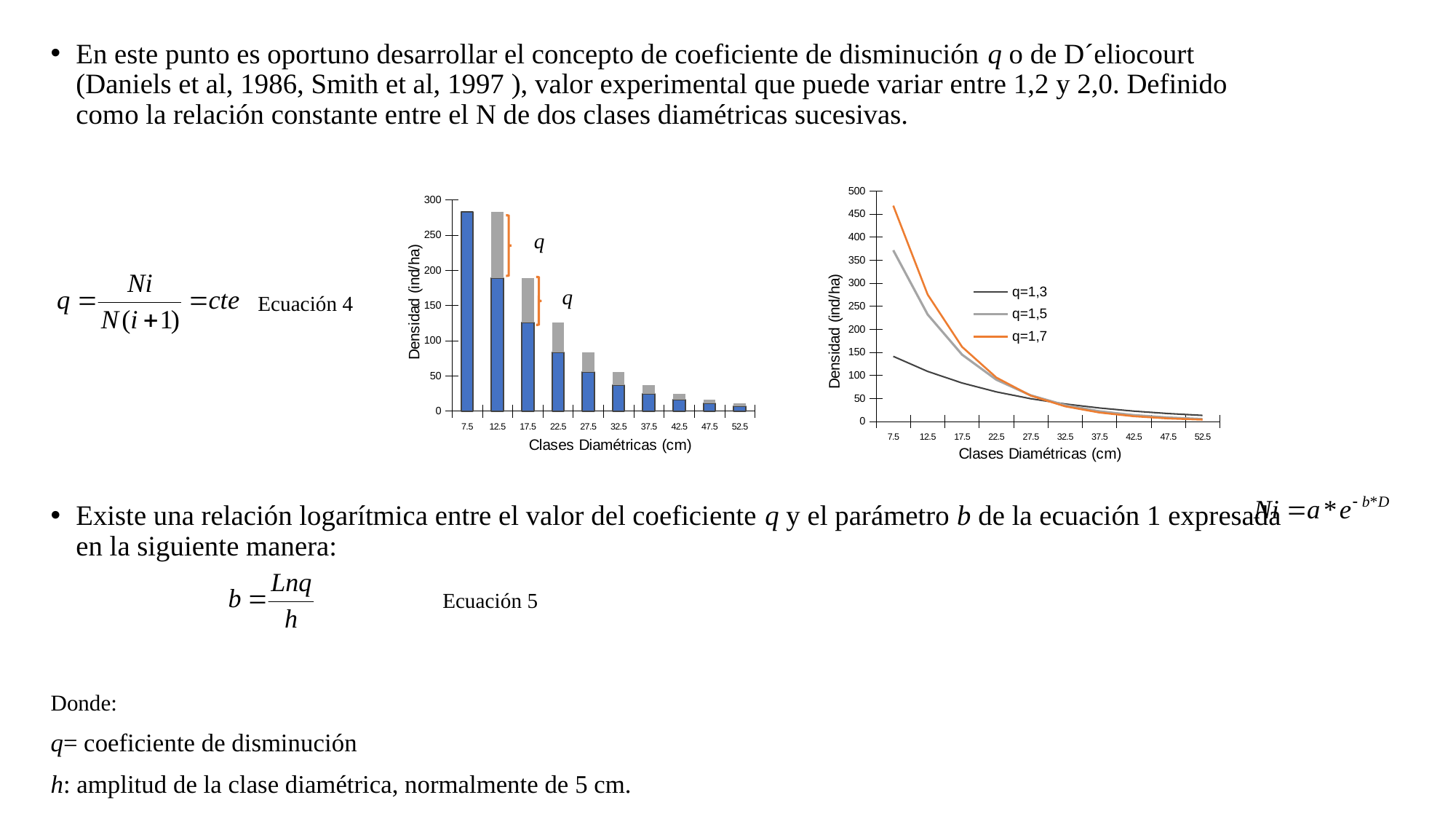
What kind of chart is the chart on the right of the slide? line chart In the chart on the right, which series has the lowest value at the 7.5 diameter class? q=1,3 In the chart on the left, is the value of the blue bar at 7.5 greater or less than 250? greater What kind of chart is the chart on the left of the slide? bar chart In the chart on the left, do the bar values rise or fall as the diameter class increases along the x axis? fall In the chart on the right, at the 7.5 diameter class, which is larger: the q=1,5 series or the q=1,3 series? q=1,5 In the chart on the right, which series has the highest value at the 7.5 diameter class? q=1,7 In the chart on the right, is the value of the q=1,7 series at 7.5 greater or less than 400? greater In the chart on the left, how many diameter classes are shown on the x axis? 10 What is the x-axis title of the chart on the right? Clases Diamétricas (cm) In the chart on the right, how many series does the legend list? 3